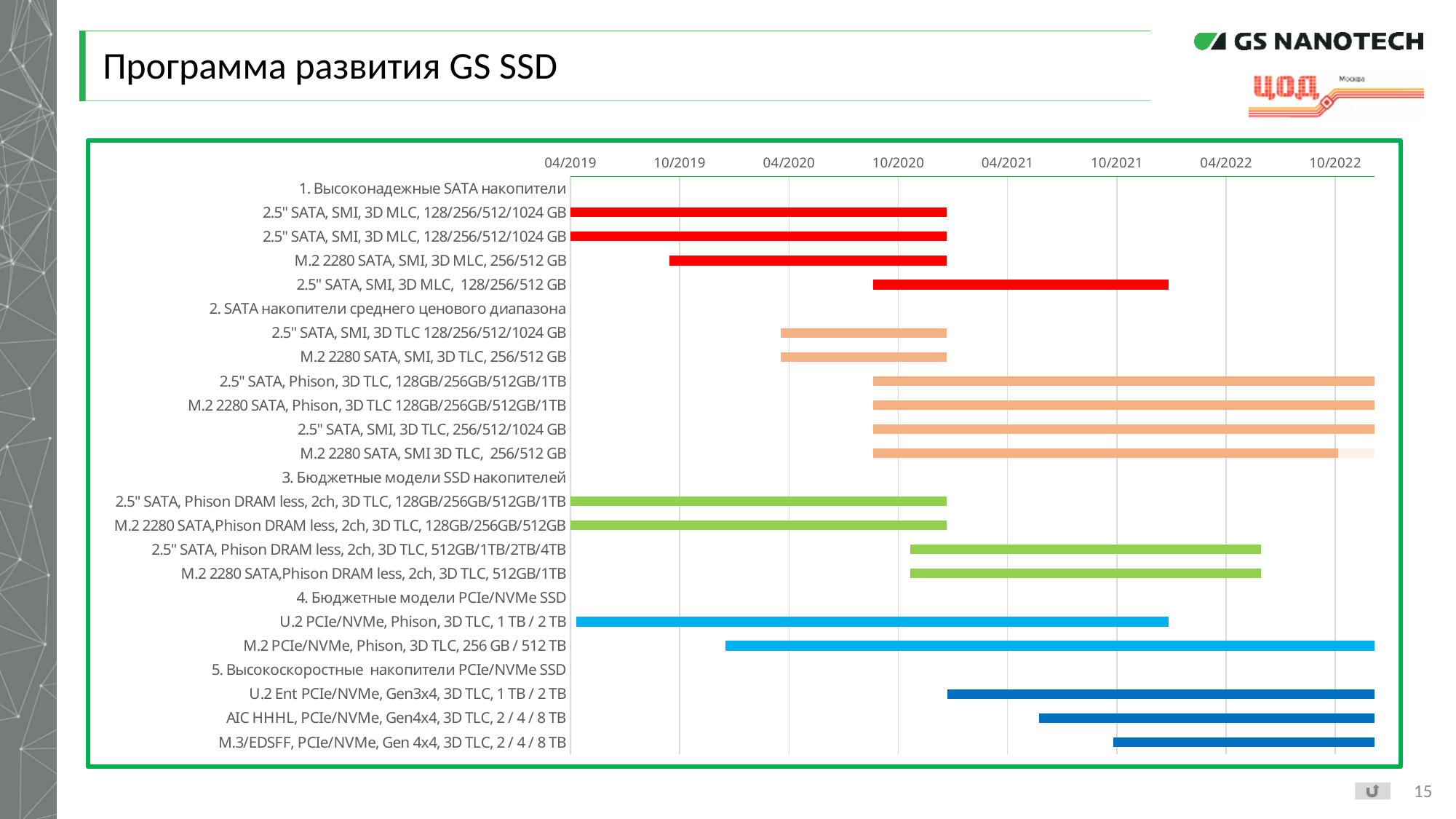
Does the bar for "2.5" SATA, Phison DRAM less, 2ch, 3D TLC, 512GB/1TB/2TB/4TB" end before or after 04/2022? after What is the earliest date label on the horizontal axis? 04/2019 Which bar ends later: "2.5" SATA, SMI, 3D MLC, 128/256/512 GB" or "2.5" SATA, SMI, 3D TLC 128/256/512/1024 GB"? 2.5" SATA, SMI, 3D MLC, 128/256/512 GB What is the title of the slide containing the chart? Программа развития GS SSD Does the bar for "AIC HHHL, PCIe/NVMe, Gen4x4, 3D TLC, 2 / 4 / 8 TB" start before or after 04/2021? after Does the bar for "M.2 2280 SATA, SMI, 3D MLC, 256/512 GB" start before or after 04/2020? before Which bar starts earlier: "U.2 PCIe/NVMe, Phison, 3D TLC, 1 TB / 2 TB" or "M.2 PCIe/NVMe, Phison, 3D TLC, 256 GB / 512 TB"? U.2 PCIe/NVMe, Phison, 3D TLC, 1 TB / 2 TB How many date labels are shown along the horizontal axis? 8 What kind of chart is shown on the slide? bar chart (Gantt timeline) How many numbered product groups are listed on the chart's vertical axis? 5 How many product rows on the chart have a bar plotted? 19 Within group 5 (Высокоскоростные накопители PCIe/NVMe SSD), which product's bar starts latest? M.3/EDSFF, PCIe/NVMe, Gen 4x4, 3D TLC, 2 / 4 / 8 TB